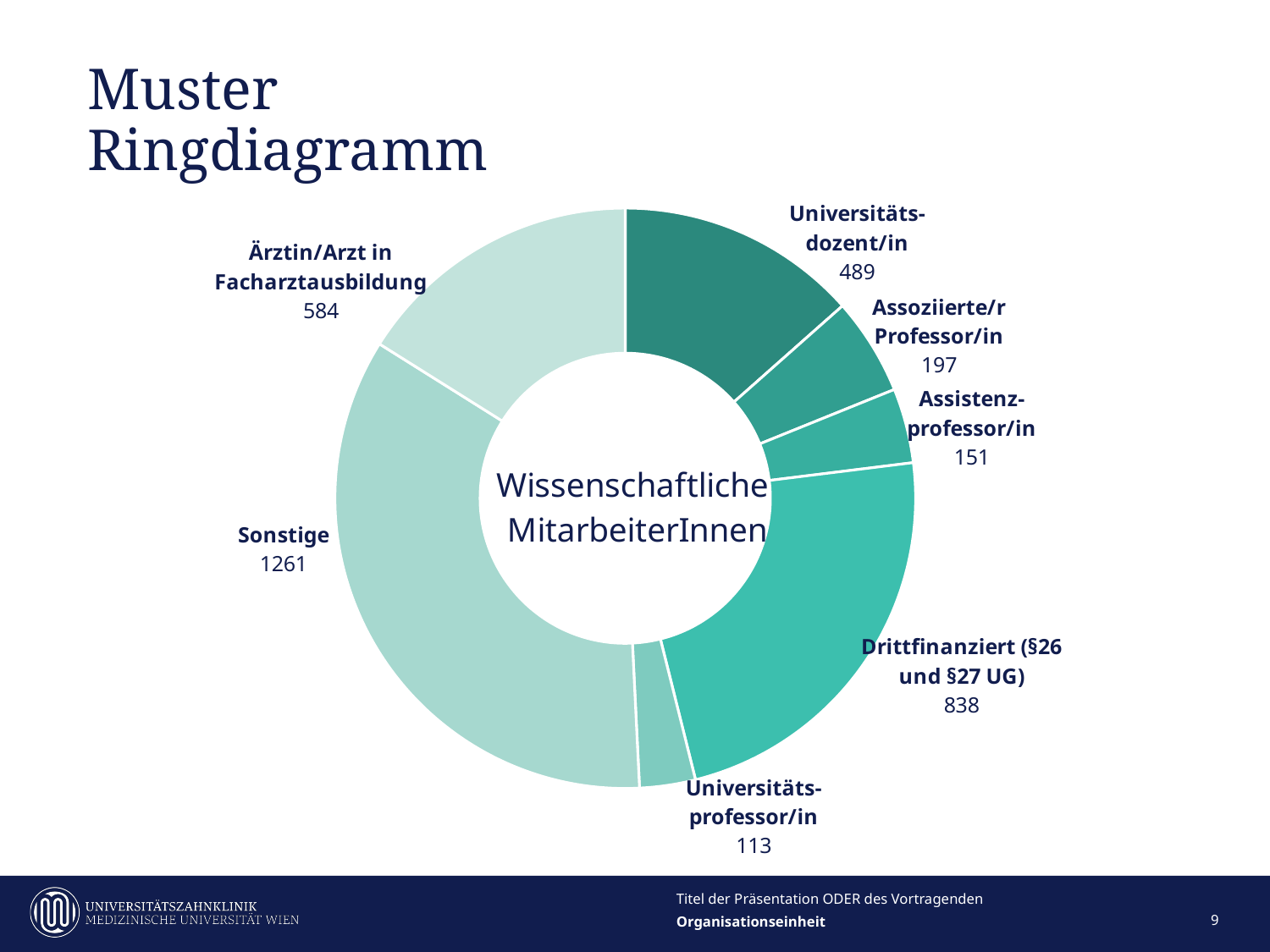
What is the value for Sonstige? 1261 What is the value for Drittfinanziert (§26 und §27 UG)? 838 Which is larger, the value for Assistenzprofessor/in or the value for Assoziierte/r Professor/in? Assoziierte/r Professor/in How many categories does the chart show? 7 What text is shown in the centre of the ring chart? Wissenschaftliche MitarbeiterInnen What is the difference between the values for Universitätsdozent/in and Assoziierte/r Professor/in? 292 What is the value for Ärztin/Arzt in Facharztausbildung? 584 Which category has the lowest value? Universitätsprofessor/in Which category has the highest value? Sonstige What kind of chart is shown on the slide? Doughnut chart What is the value for Universitätsprofessor/in? 113 What is the difference between the values for Sonstige and Drittfinanziert (§26 und §27 UG)? 423